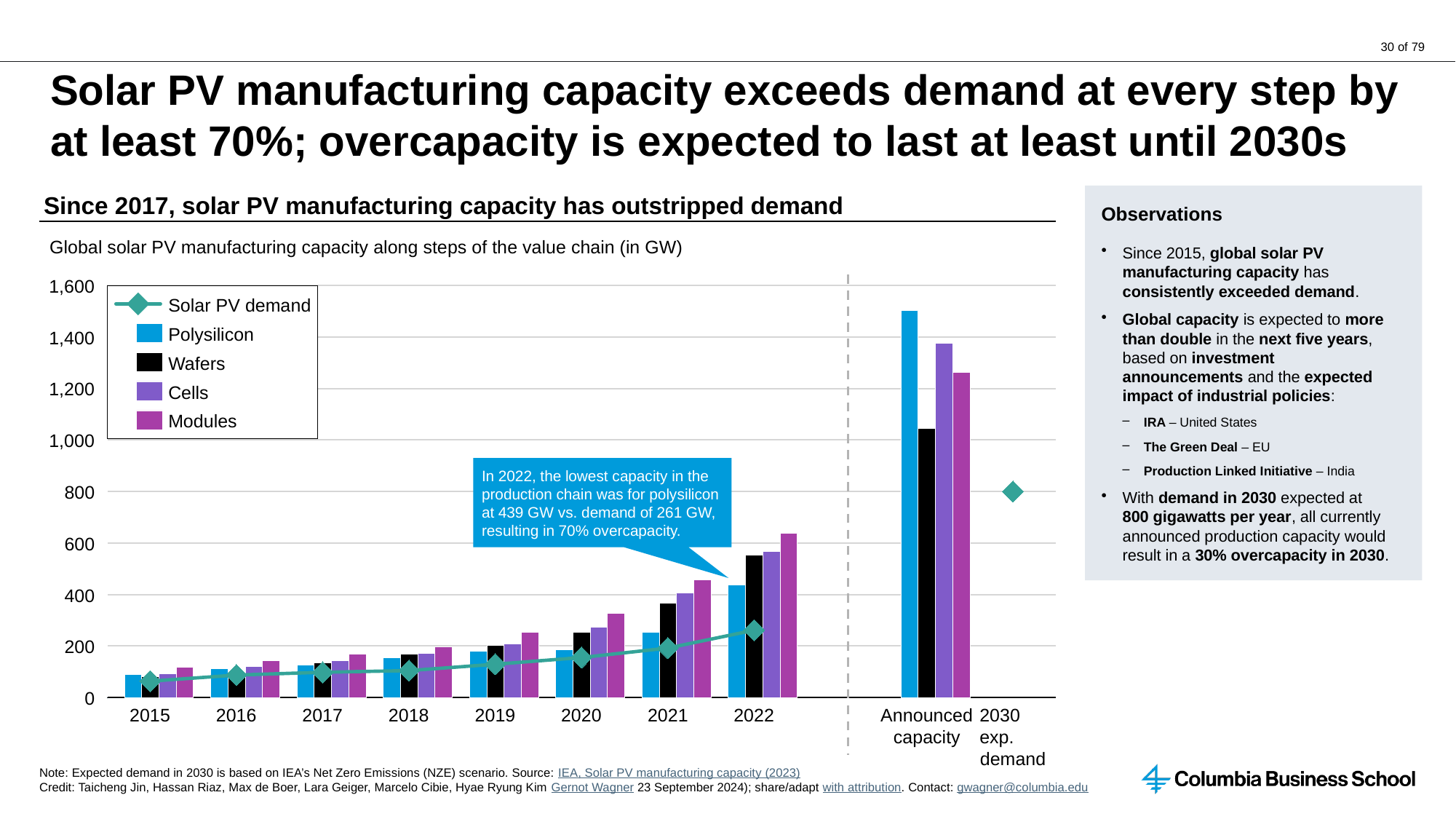
Is the announced capacity for polysilicon greater or less than 1,400? greater In 2022, which is larger: the capacity for Modules or for Wafers? Modules Which value chain step has the highest announced capacity? Polysilicon What is the expected solar PV demand in 2030 shown by the marker on the right of the chart? 800 GW How many series does the chart legend list? 5 What kind of chart is shown on the slide? combination bar and line chart Which value chain step had the lowest capacity in 2022? Polysilicon What was the polysilicon manufacturing capacity in 2022, according to the callout? 439 GW How many years from 2015 onward are shown on the x axis before the dashed line? 8 Does polysilicon capacity rise or fall from 2015 to 2022? rise What is the difference between polysilicon capacity and solar PV demand in 2022? 178 GW What was solar PV demand in 2022, according to the callout? 261 GW